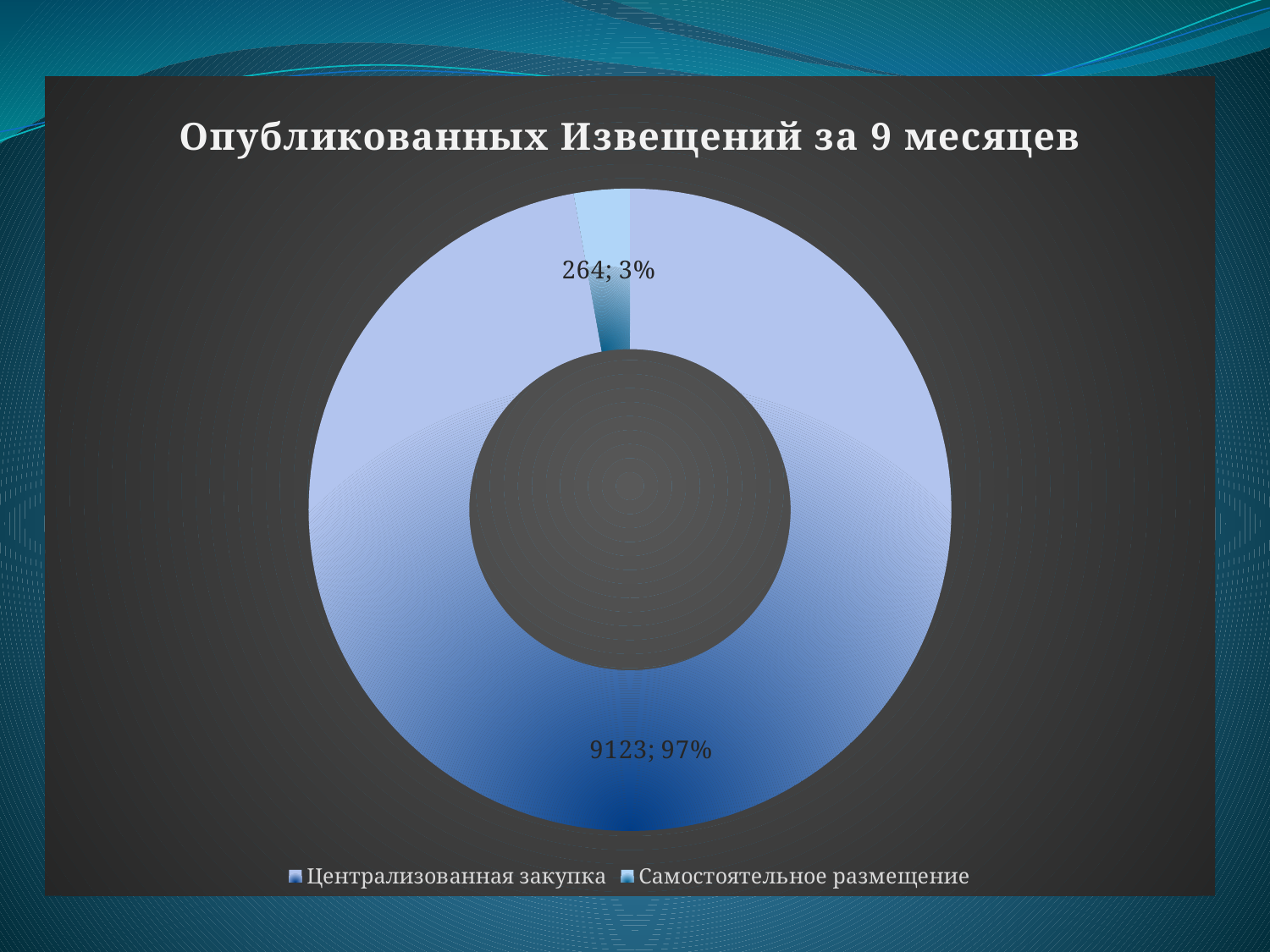
What share of the chart does Самостоятельное размещение represent? 3% What kind of chart is shown on the slide? Doughnut (pie) chart Which category has the largest slice? Централизованная закупка What is the value for Самостоятельное размещение? 264 How many slices does the chart have? 2 What is the difference between the values for Централизованная закупка and Самостоятельное размещение? 8859 What is the value for Централизованная закупка? 9123 Which category has the smallest slice? Самостоятельное размещение What is the title of the chart? Опубликованных Извещений за 9 месяцев What share of the chart does Централизованная закупка represent? 97% What is the total of the two values shown on the chart? 9387 How many categories does the legend list? 2